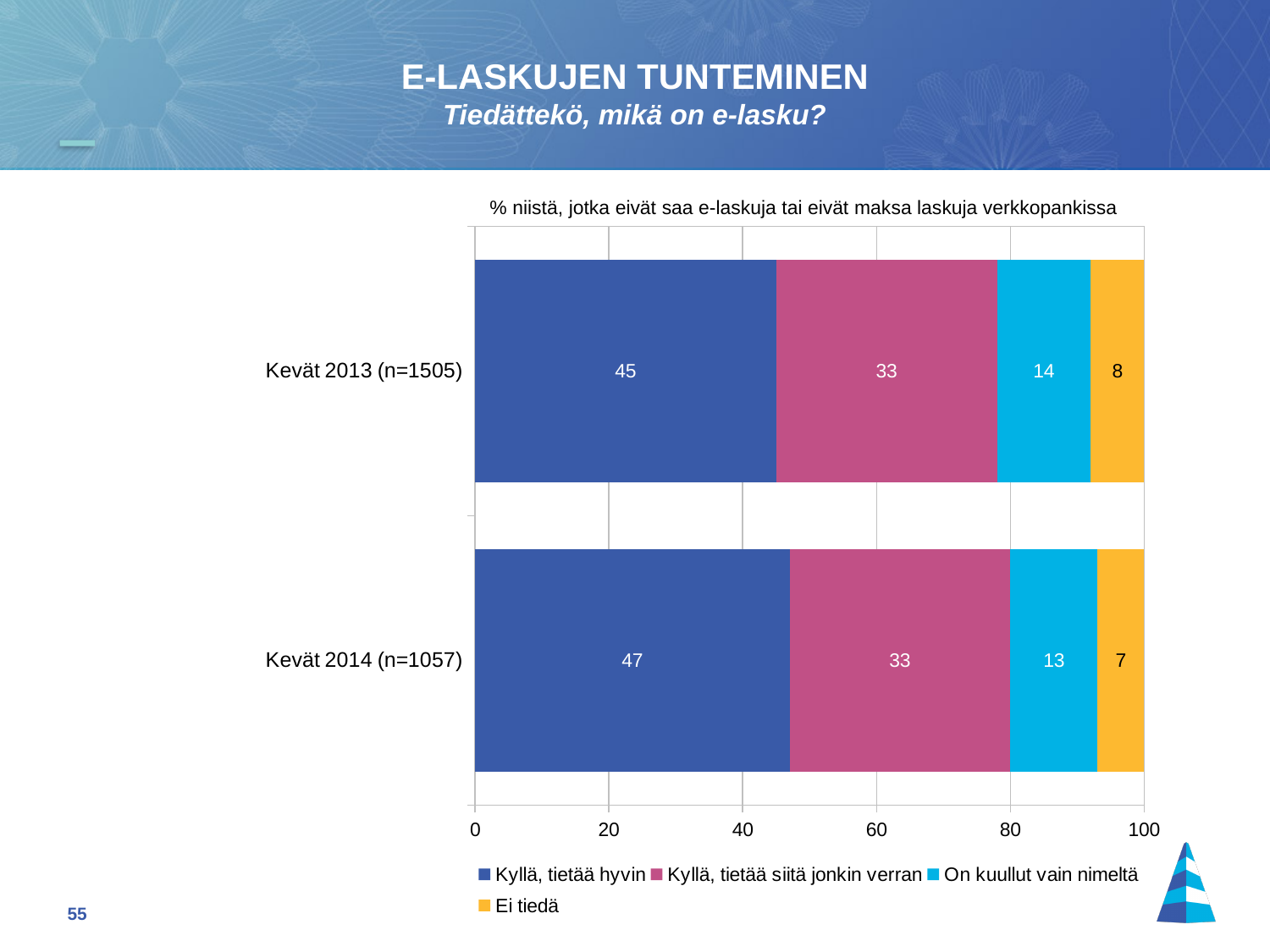
What is the value for "Kyllä, tietää hyvin" for Kevät 2013 (n=1505)? 45 Which series is shown in yellow in the legend? Ei tiedä What is the value for "On kuullut vain nimeltä" for Kevät 2013 (n=1505)? 14 What is the value for "Kyllä, tietää siitä jonkin verran" for Kevät 2014 (n=1057)? 33 Which category has the higher value for "Kyllä, tietää hyvin", Kevät 2013 (n=1505) or Kevät 2014 (n=1057)? Kevät 2014 (n=1057) What is the total of the stacked bar for Kevät 2014 (n=1057)? 100 What is the difference between the "Kyllä, tietää hyvin" values for Kevät 2014 (n=1057) and Kevät 2013 (n=1505)? 2 What is the total of the stacked bar for Kevät 2013 (n=1505)? 100 How many categories are shown on the chart? 2 What is the value for "Ei tiedä" for Kevät 2014 (n=1057)? 7 What kind of chart is shown on the slide? Stacked bar chart How many series does the legend list? 4